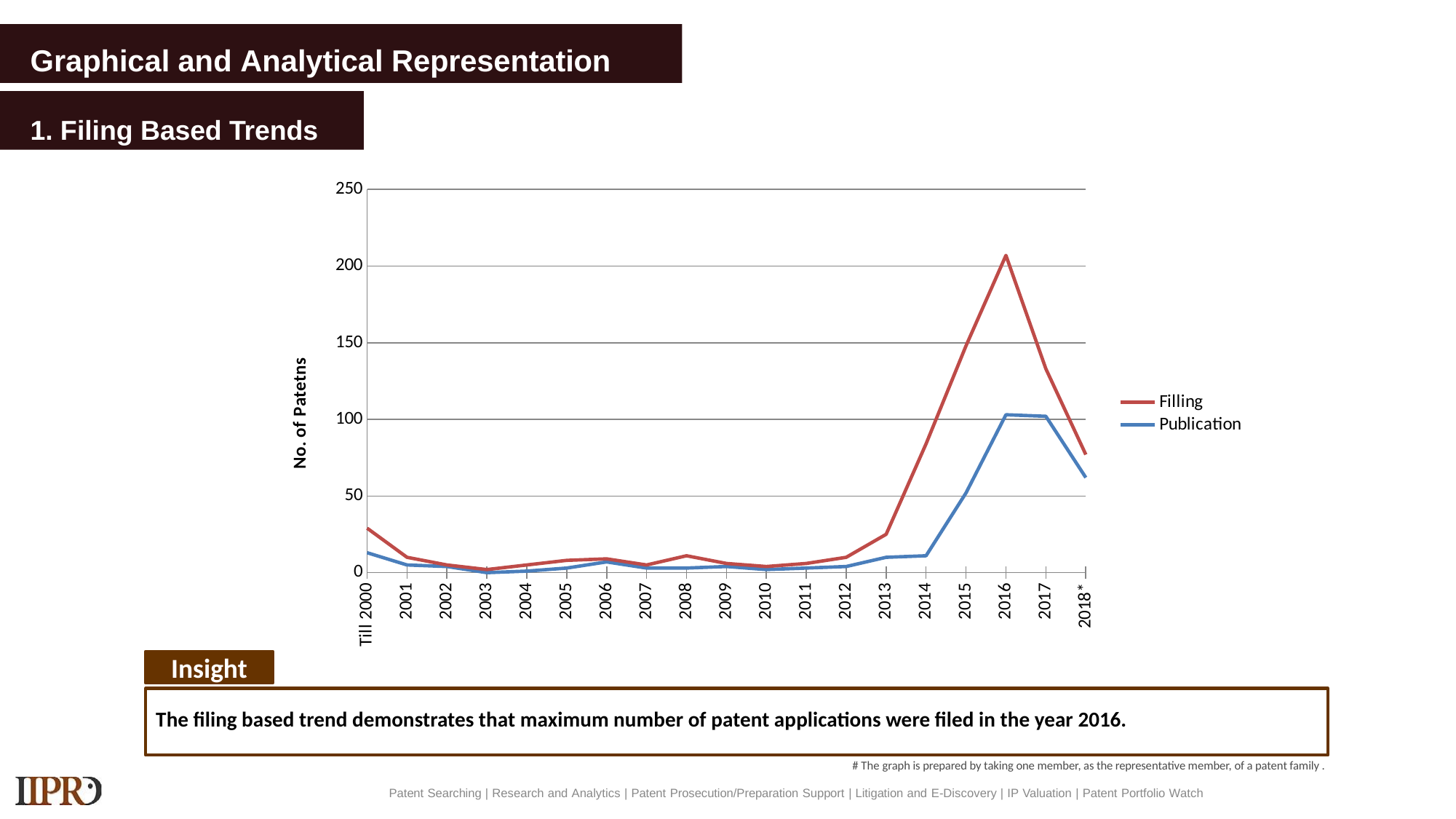
How many series does the legend list? 2 In which year does the Filling series reach its highest value? 2016 Is the Publication value for 2018* greater or less than 50? greater What are the two series named in the legend? Filling and Publication In which year is the Filling series at its lowest value? 2003 How many year categories are shown on the x axis? 19 Does the Filling series rise or fall from 2014 to 2016? rise Is the Filling value for 2016 greater or less than 200? greater Which series has the larger value in 2016, Filling or Publication? Filling What is the label on the vertical axis? No. of Patetns What kind of chart is shown on the slide? line chart Is the Filling value for 2017 greater or less than 150? less